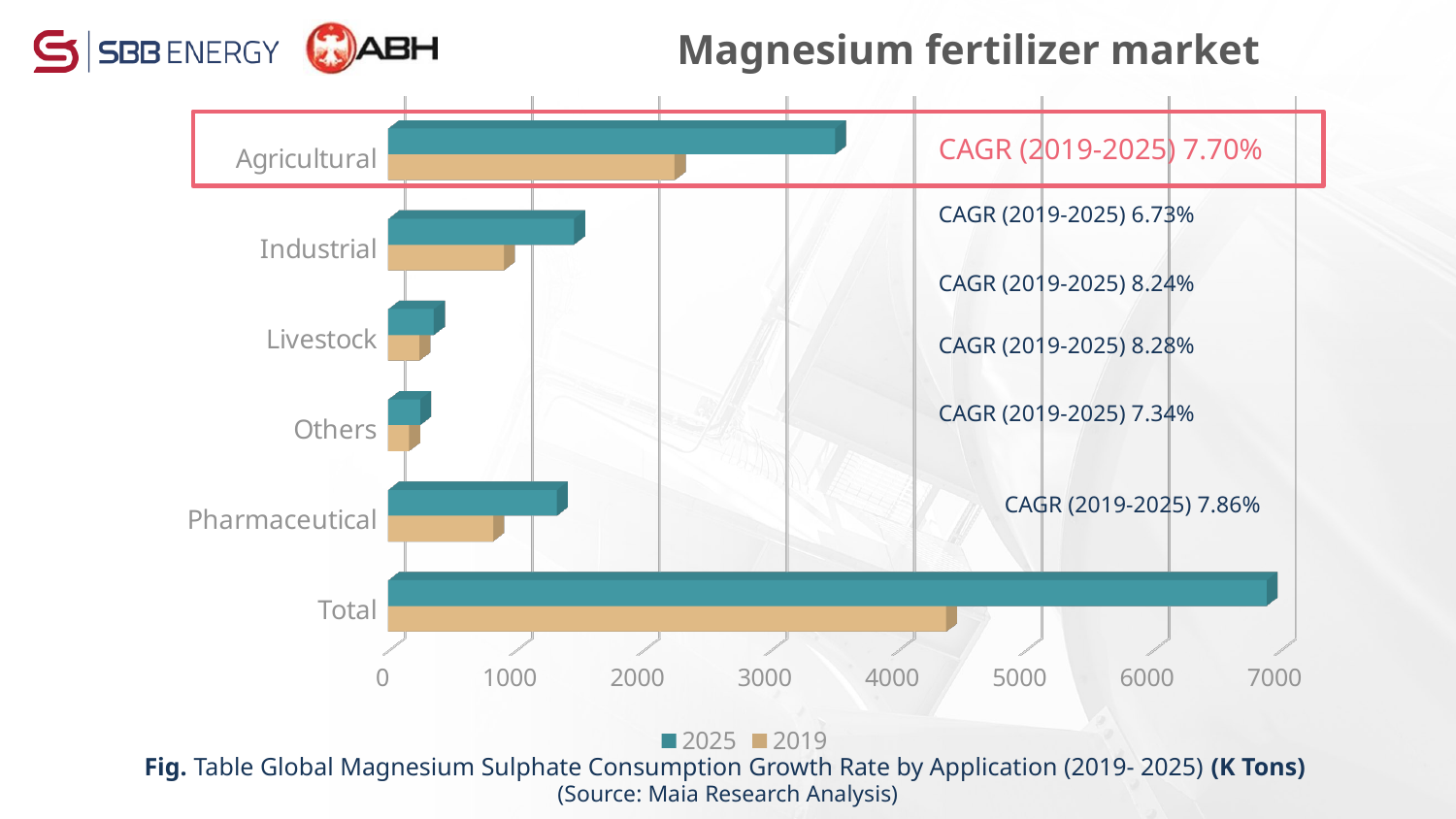
What kind of chart is shown on the slide? Bar chart Is the 2019 value for Total greater or less than 4000? greater Which category has the longest 2025 bar? Total How many categories are shown on the vertical axis of the chart? 6 Is the 2025 value for Total greater or less than 6000? greater How many series does the legend list? 2 What CAGR (2019-2025) is printed for the Agricultural application? 7.70% Is the 2025 value for Agricultural greater or less than 3000? greater Which is larger, the 2025 value for Agricultural or the 2025 value for Industrial? Agricultural What is the title of the chart on the slide? Magnesium fertilizer market Excluding Total, which application has the longest 2025 bar? Agricultural